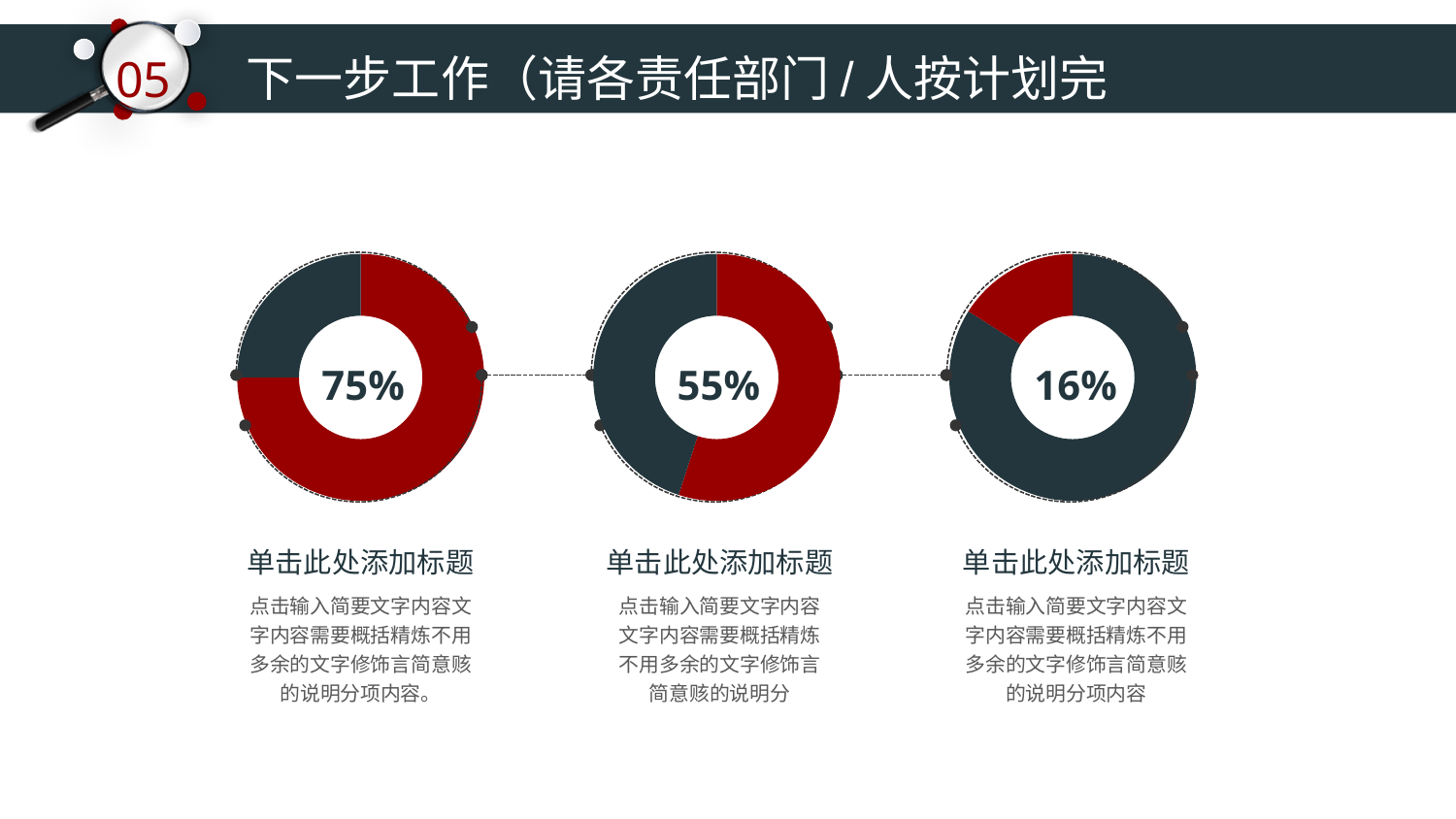
What percentage is shown in the centre of the right donut chart? 16% What kind of chart is used for the three figures on this slide? Donut (pie) chart What is the difference between the percentage in the left donut chart and the percentage in the middle donut chart? 20 percentage points In the right donut chart, what share of the ring does the red slice represent? 16% Which donut chart shows the highest percentage: left, middle or right? Left (75%) How many donut charts are on the slide? 3 Which is larger, the percentage in the left donut chart or the percentage in the middle donut chart? Left (75%) What is the difference between the percentage in the middle donut chart and the percentage in the right donut chart? 39 percentage points What colour is the slice that represents the stated percentage in each donut chart? Red Which donut chart shows the lowest percentage: left, middle or right? Right (16%) What percentage is shown in the centre of the left donut chart? 75% What percentage is shown in the centre of the middle donut chart? 55%